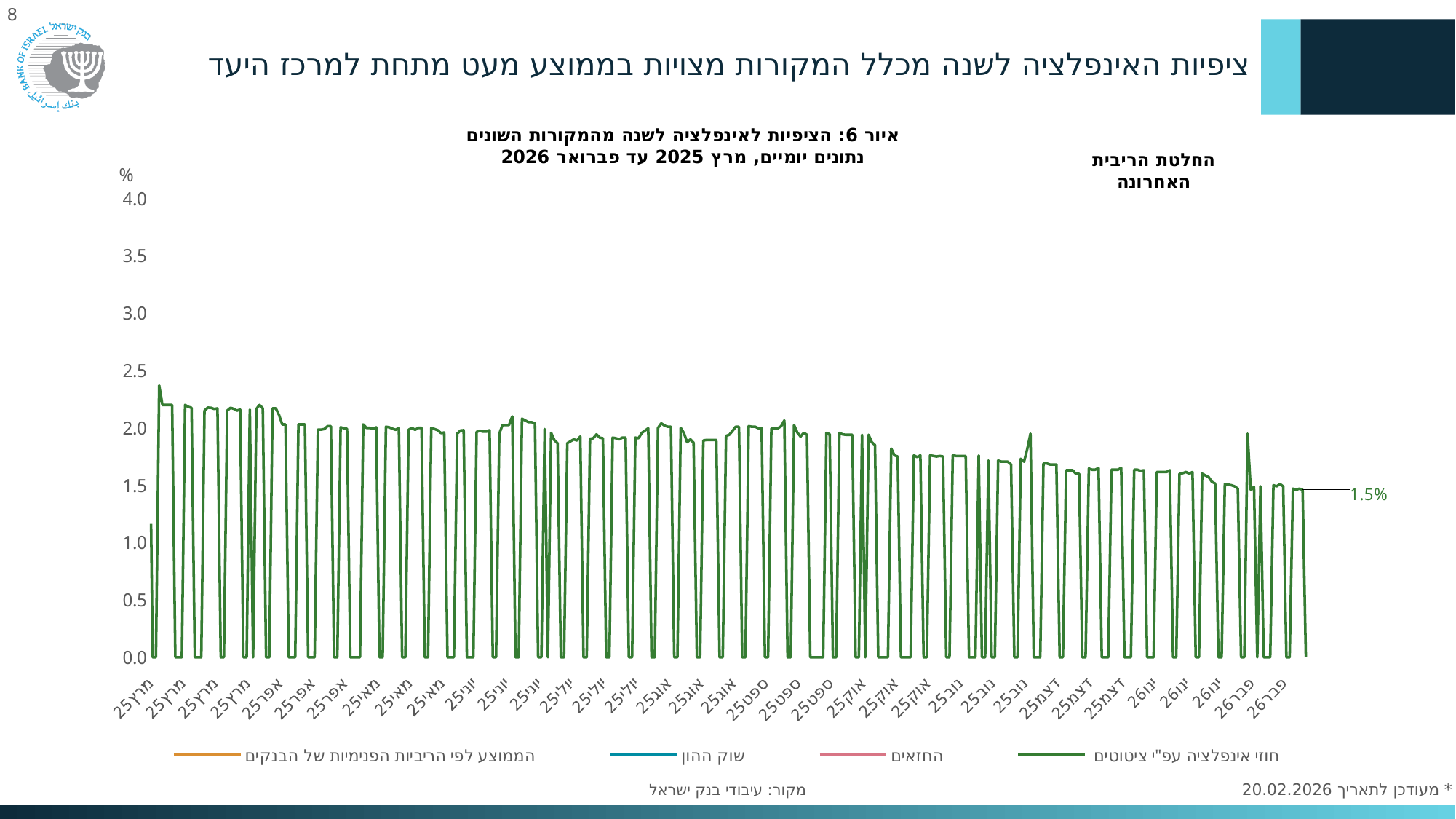
Which month label appears last on the horizontal axis? פבר26 Is the highest point of the green line greater or less than 3.0? less Is the final labelled value of the green line greater or less than 2.0? less What kind of chart is shown on the slide? line chart What is the value shown by the data label at the end of the green line (February 2026)? 1.5% Does the green line (inflation contracts by quotes) generally rise or fall from March 2025 to February 2026? fall What unit is shown at the top of the vertical axis? % What is the maximum value shown on the vertical axis? 4.0 How many series does the legend list? 4 Which month label appears first on the horizontal axis? מרץ25 Is the highest point of the green line in March 2025 greater or less than 2.0? greater